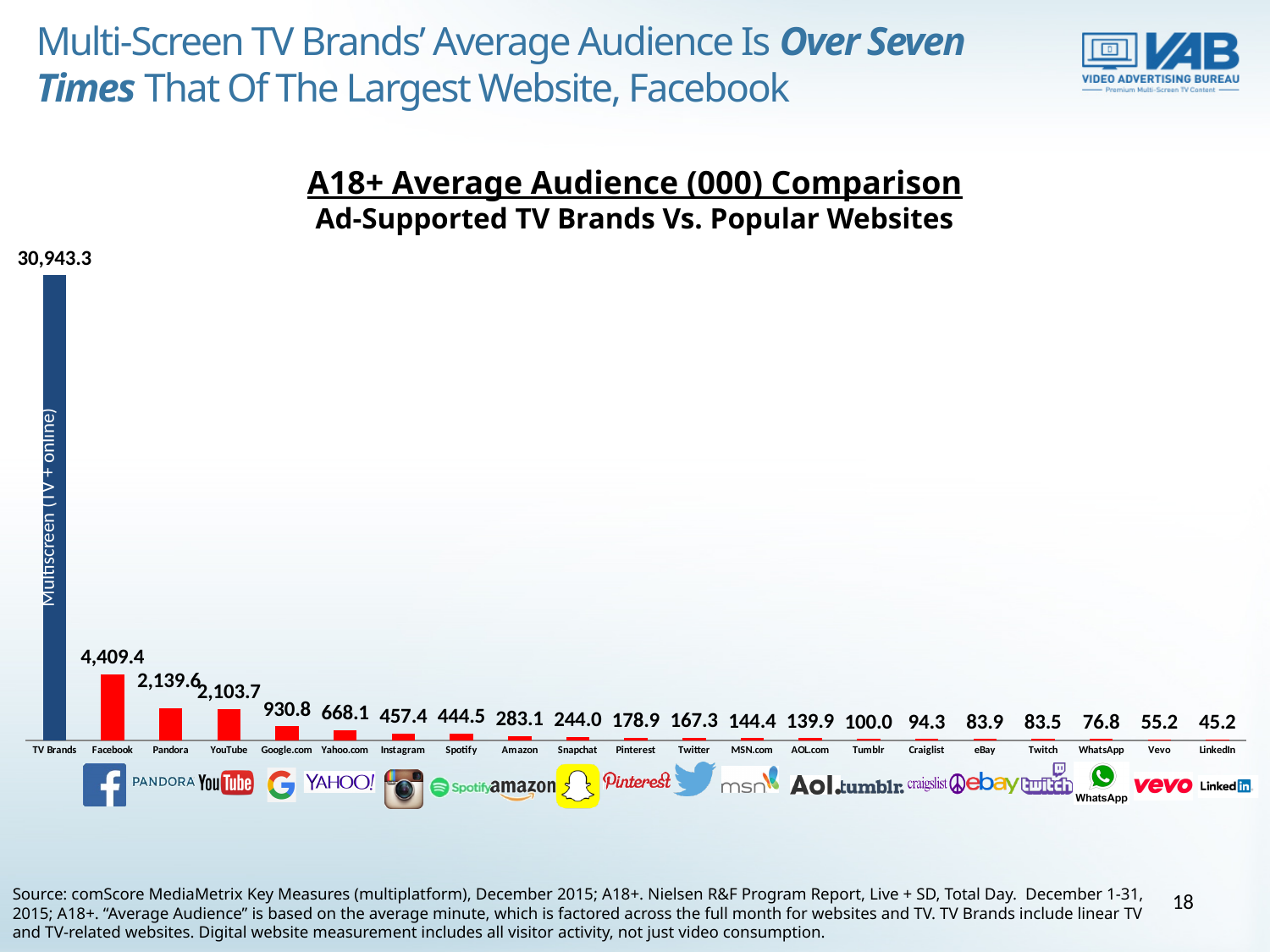
What is the difference between the Facebook value and the Pandora value? 2,269.8 Which category has the highest average audience? TV Brands What is the value shown for Snapchat? 244.0 What is the A18+ average audience (000) for TV Brands? 30,943.3 Which has a larger value, Pandora or YouTube? Pandora What is the difference between the TV Brands value and the Facebook value? 26,533.9 What type of chart is shown on the slide? Bar chart What is the value shown for Twitch? 83.5 What is the value shown for Facebook? 4,409.4 Which category has the lowest average audience? LinkedIn How many categories are plotted in the chart? 21 What is the title of the chart? A18+ Average Audience (000) Comparison